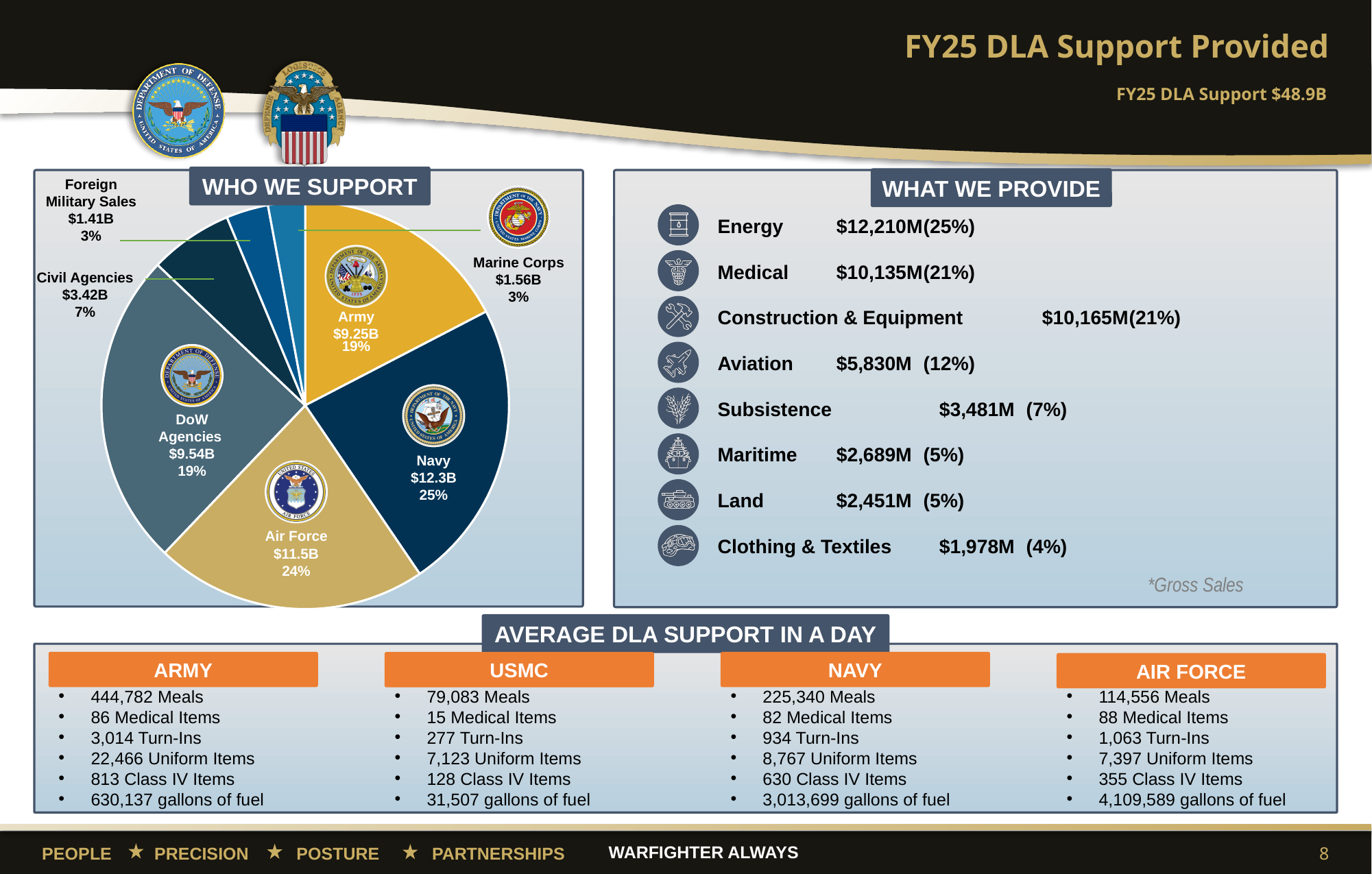
In the "WHO WE SUPPORT" pie chart, which is larger: the Navy or the Air Force? Navy In the "WHO WE SUPPORT" pie chart, what share of the pie does the Army represent? 19% In the "WHO WE SUPPORT" pie chart, what is the value for the Navy? $12.3B What is the title of the pie chart on the slide? WHO WE SUPPORT In the "WHO WE SUPPORT" pie chart, what is the difference between the Navy value and the Air Force value? $0.8B In the "WHO WE SUPPORT" pie chart, what is the value for the Air Force? $11.5B How many slices does the "WHO WE SUPPORT" pie chart have? 7 In the "WHO WE SUPPORT" pie chart, what is the value for Foreign Military Sales? $1.41B In the "WHO WE SUPPORT" pie chart, what share of the pie does the Marine Corps represent? 3% In the "WHO WE SUPPORT" pie chart, what is the value for Civil Agencies? $3.42B What type of chart is shown under "WHO WE SUPPORT"? Pie chart